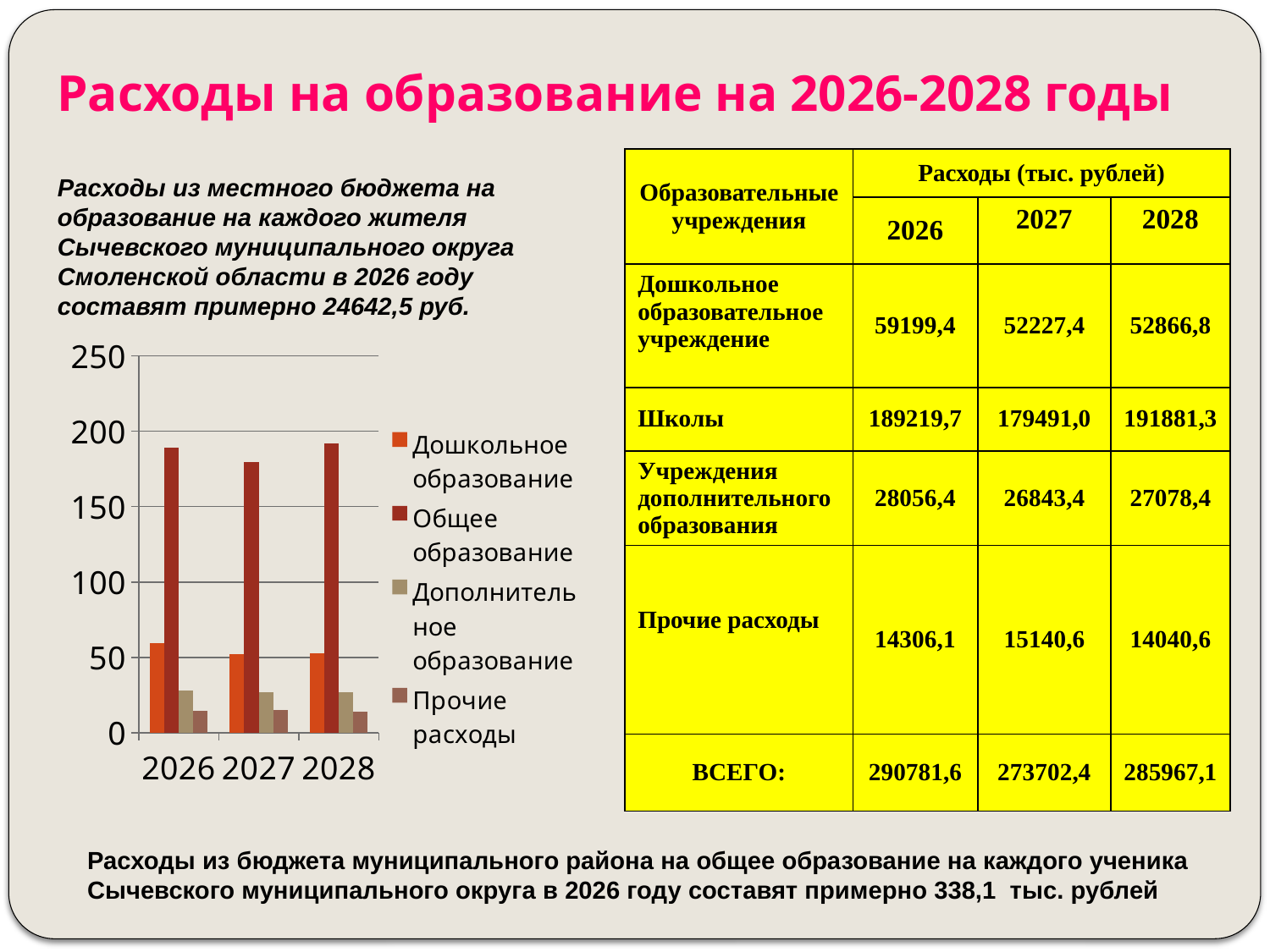
Is the value for Дошкольное образование in 2026 greater or less than 50? greater How many series does the chart legend list? 4 Is the value for Дополнительное образование in 2027 greater or less than 50? less What colour are the bars for Общее образование in the chart? dark red Which series has the tallest bar in 2026? Общее образование Is the value for Общее образование in 2026 greater or less than 150? greater What kind of chart is shown on the slide? bar chart Which series has the shortest bar in 2028? Прочие расходы Does the value for Дошкольное образование rise or fall from 2026 to 2027? fall Which is larger: Общее образование in 2027 or Общее образование in 2028? 2028 How many years are shown on the x axis of the chart? 3